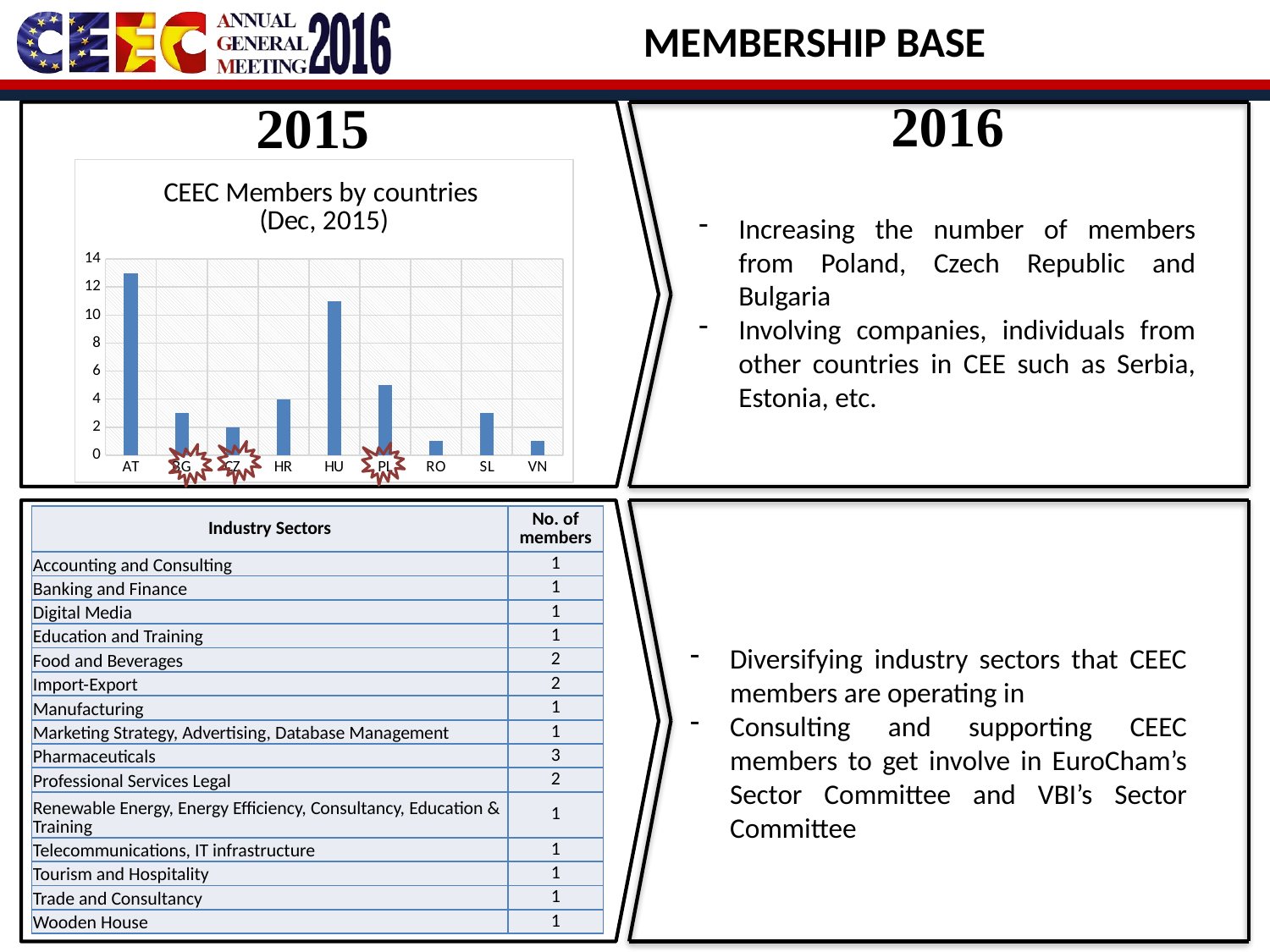
Is the value for RO greater or less than 2? less What is the value for CZ in the chart? 2 Is the value for PL greater or less than 4? greater Is the value for AT greater or less than 12? greater What is the value for HR in the chart? 4 What kind of chart is shown on the slide? bar chart Which has more members, AT or HU? AT What is the title of the chart? CEEC Members by countries (Dec, 2015) Which has more members, HU or PL? HU Which country has the highest number of members in the chart? AT How many countries are shown on the x axis of the chart? 9